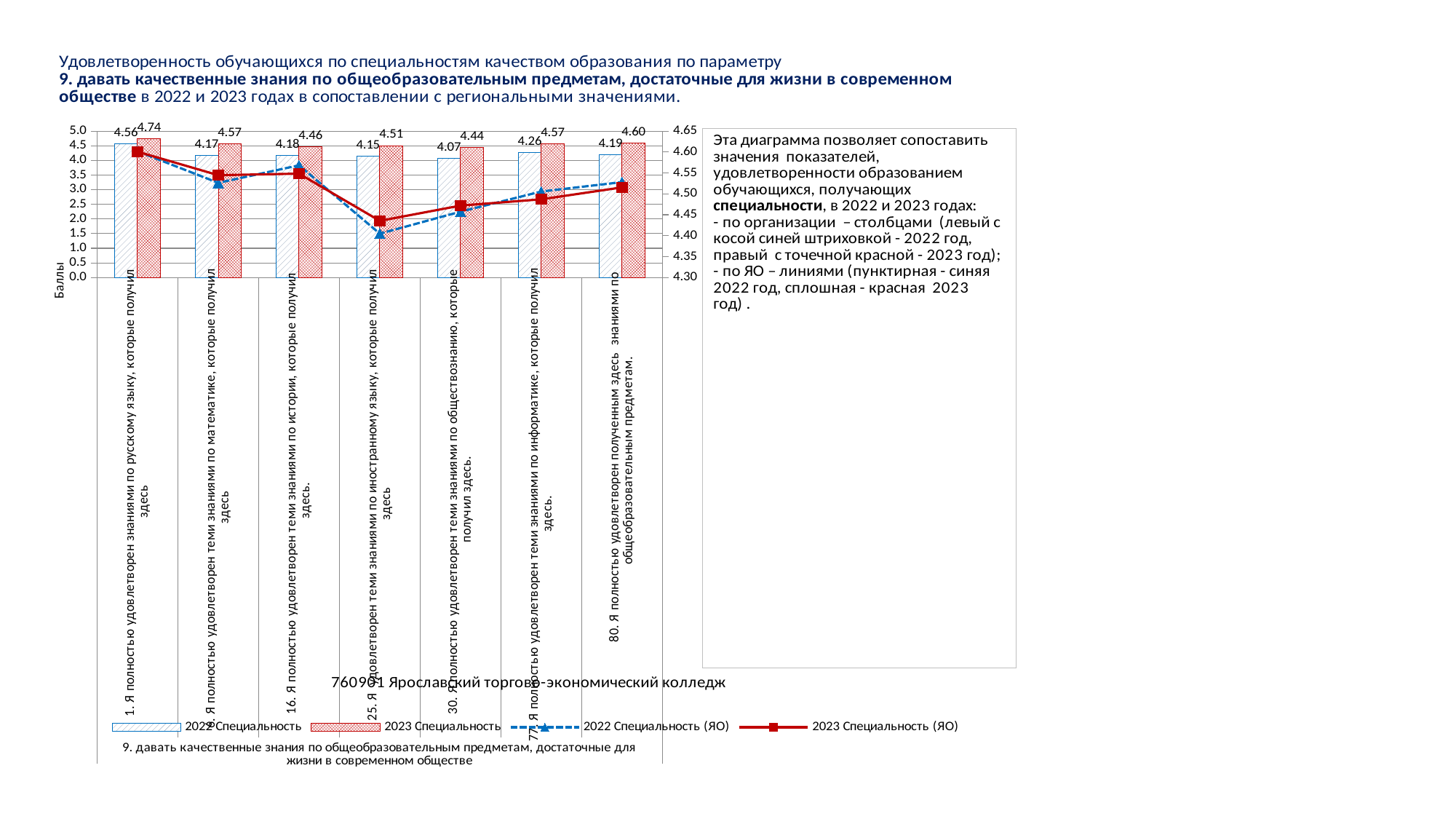
What is the value of the 2023 Специальность bar for the category about knowledge in mathematics (item 9)? 4.57 Which category has the lowest 2022 Специальность bar? 30. Я полностью удовлетворен теми знаниями по обществознанию, которые получил здесь Which category has the highest 2023 Специальность bar? 1. Я полностью удовлетворен знаниями по русскому языку, которые получил здесь How many categories are shown on the x axis of the chart? 7 What kind of chart is shown on the slide? A combined bar and line chart What is the value of the 2022 Специальность bar for the category about knowledge in Russian language (item 1)? 4.56 How many series does the chart legend list? 4 What is the label of the left vertical axis of the chart? Баллы What is the value of the 2023 Специальность bar for the category about knowledge in social studies (item 30)? 4.44 Which is larger: the 2023 Специальность bar for mathematics (item 9) or for history (item 16)? Mathematics (item 9) What is the difference between the 2023 and 2022 Специальность bars for the Russian language category (item 1)? 0.18 Is the 2023 Специальность (ЯО) line value for the foreign language category (item 25) greater or less than 4.50 on the right axis? less